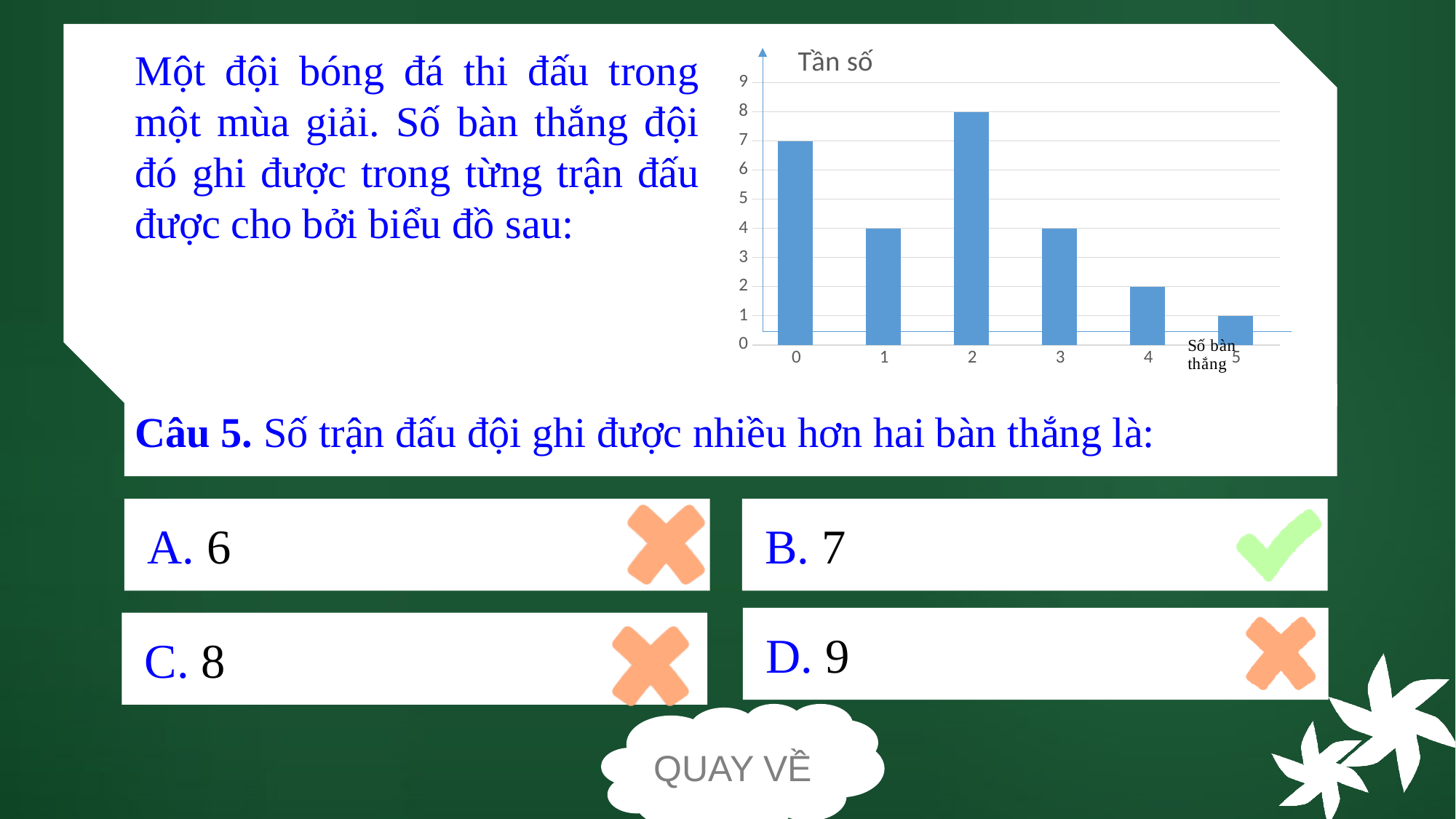
Which has a higher frequency: 0 goals or 1 goal? 0 goals How many categories (values of Số bàn thắng) are shown on the x axis? 6 Which number of goals has the lowest frequency? 5 What is the label of the vertical axis of the chart? Tần số What is the label of the horizontal axis of the chart? Số bàn thắng What kind of chart is shown on the slide? bar chart What is the frequency for 2 goals? 8 What is the frequency (Tần số) for 0 goals (Số bàn thắng = 0)? 7 Is the frequency for 3 goals greater or less than 5? less What is the frequency for 5 goals? 1 What is the difference between the frequency for 2 goals and the frequency for 4 goals? 6 Which number of goals has the highest frequency? 2